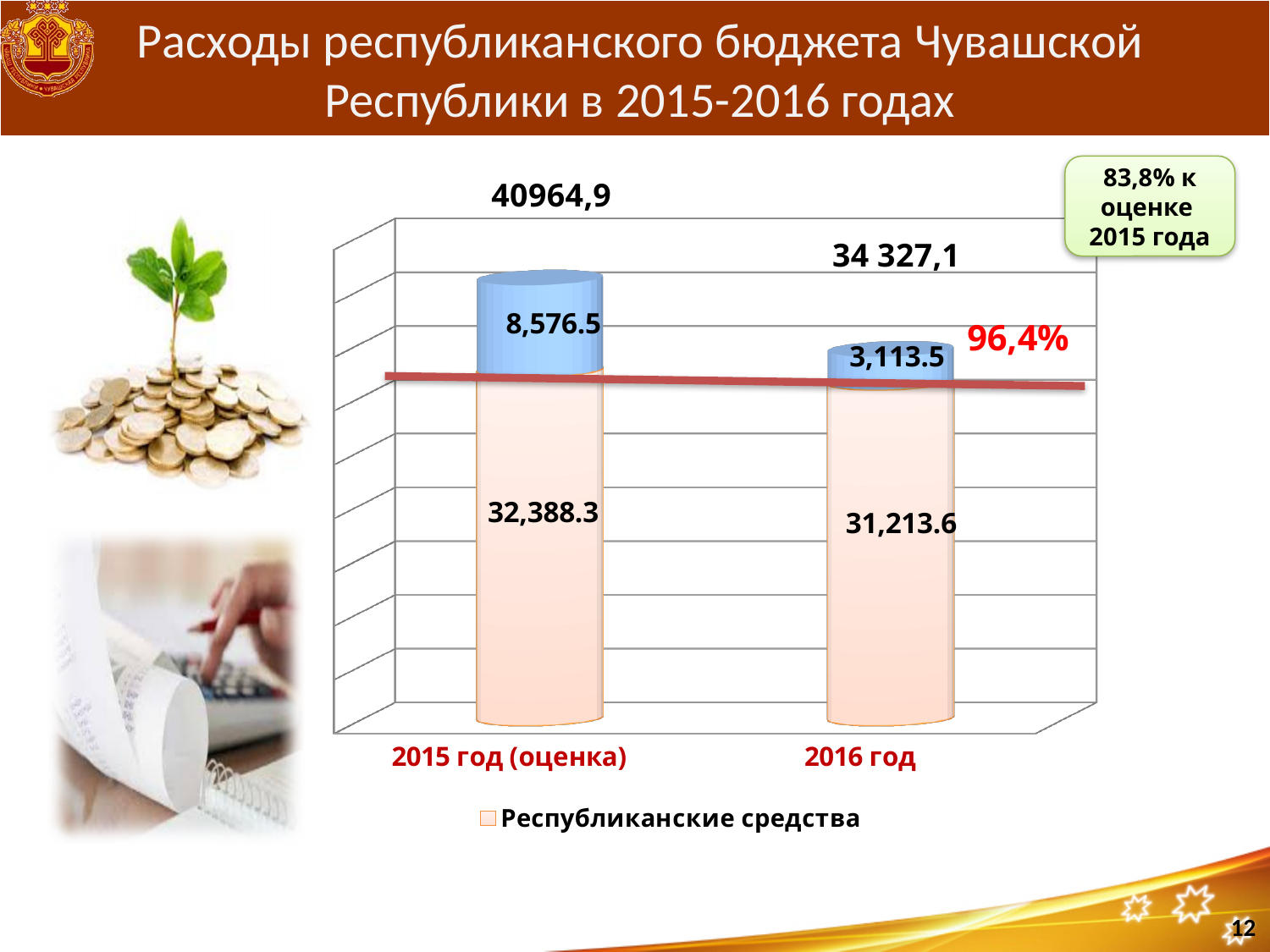
What value is labelled on the blue top segment of the 2016 год bar? 3,113.5 What is the value of Республиканские средства for 2016 год? 31,213.6 What total is printed above the 2016 год bar? 34 327,1 What is the difference between the Республиканские средства values for 2015 год (оценка) and 2016 год? 1,174.7 How many categories are shown on the x axis? 2 What is the value of Республиканские средства for 2015 год (оценка)? 32,388.3 What value is labelled on the blue top segment of the 2015 год (оценка) bar? 8,576.5 What total is printed above the 2015 год (оценка) bar? 40964,9 Is the blue top segment larger for 2015 год (оценка) or for 2016 год? 2015 год (оценка) Which year has the higher value of Республиканские средства? 2015 год (оценка) What percentage is printed in red next to the line across the chart? 96,4% Which year has the lower value on the blue top segment? 2016 год